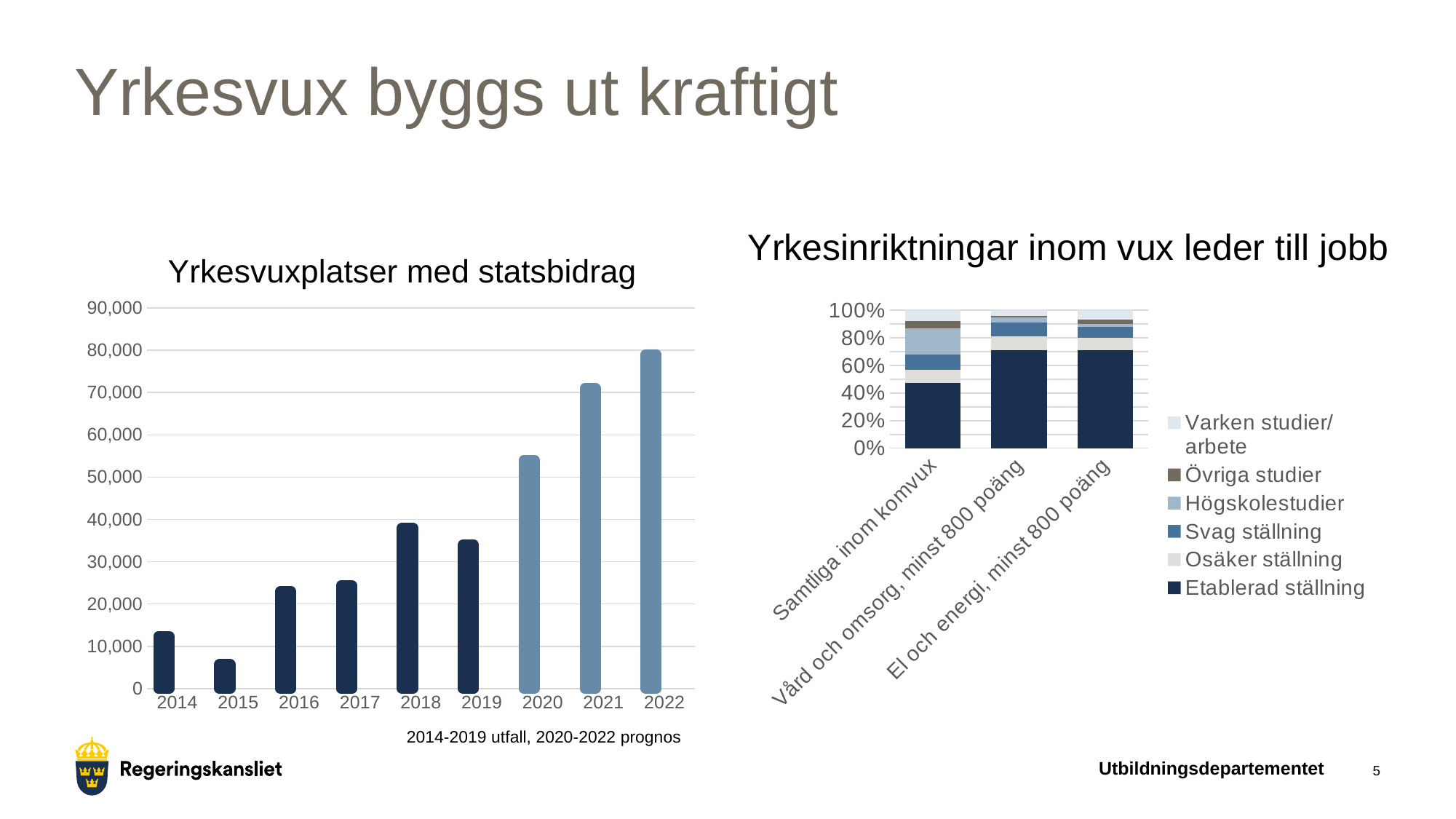
What kind of chart is the 'Yrkesvuxplatser med statsbidrag' chart on the left? bar chart In the 'Yrkesinriktningar inom vux leder till jobb' chart, how many series does the legend list? 6 In the 'Yrkesinriktningar inom vux leder till jobb' chart, how many categories are shown on the x axis? 3 According to the note under the 'Yrkesvuxplatser med statsbidrag' chart, which years are prognos (forecast)? 2020-2022 In the 'Yrkesvuxplatser med statsbidrag' chart, which year has the lowest bar? 2015 In the 'Yrkesvuxplatser med statsbidrag' chart, which year has the larger value, 2018 or 2019? 2018 In the 'Yrkesvuxplatser med statsbidrag' chart, which year has the highest bar? 2022 In the 'Yrkesvuxplatser med statsbidrag' chart, do the values rise or fall from 2019 to 2022? rise In the 'Yrkesinriktningar inom vux leder till jobb' chart, is the 'Etablerad ställning' share for 'Vård och omsorg, minst 800 poäng' greater or less than 60%? greater In the 'Yrkesvuxplatser med statsbidrag' chart, is the value for 2014 greater or less than 20,000? less In the 'Yrkesvuxplatser med statsbidrag' chart, is the value for 2021 greater or less than 60,000? greater In the 'Yrkesvuxplatser med statsbidrag' chart, how many years are shown on the x axis? 9